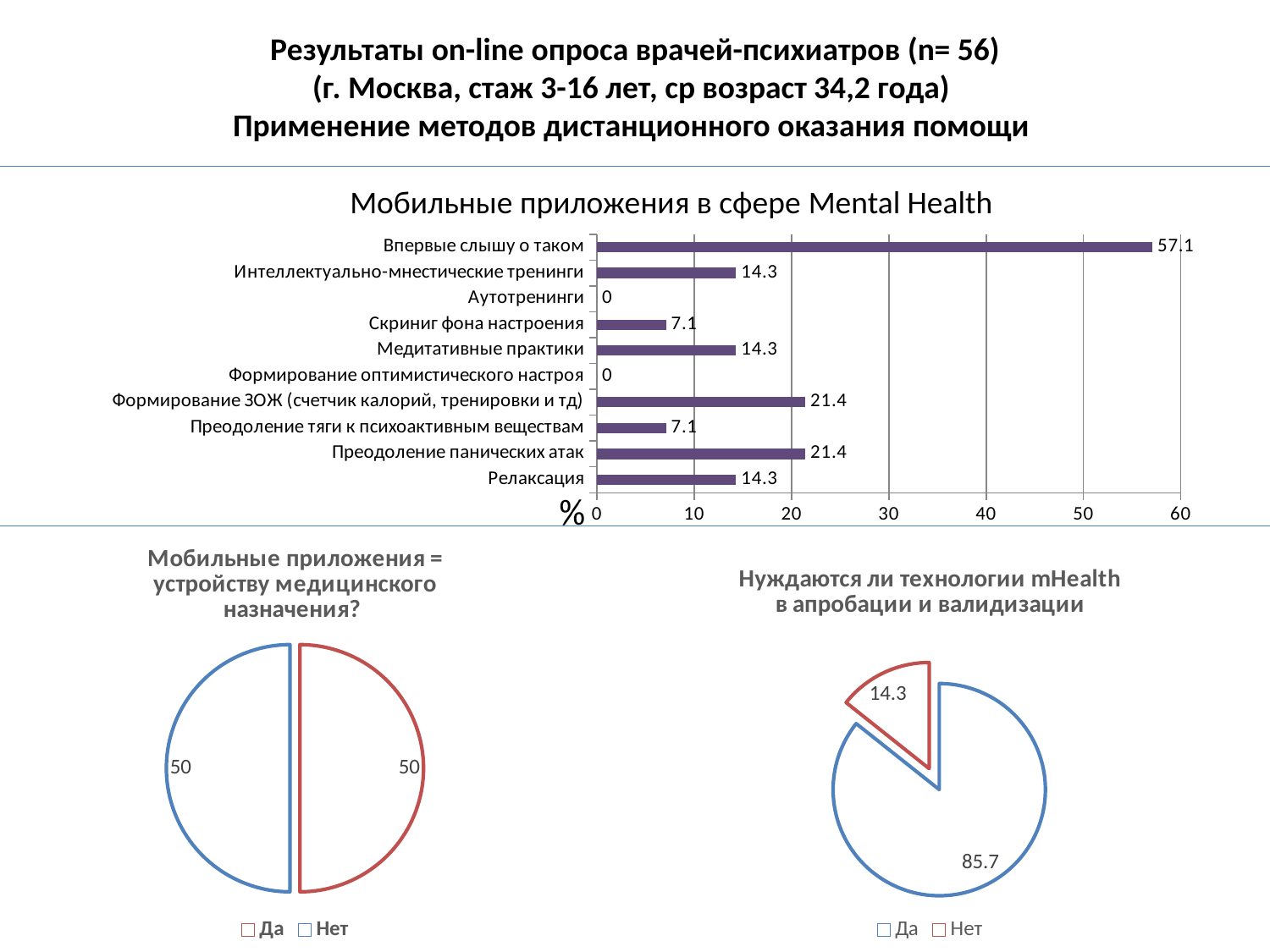
In the bar chart 'Мобильные приложения в сфере Mental Health', what is the value for 'Впервые слышу о таком'? 57.1 In the bar chart 'Мобильные приложения в сфере Mental Health', what is the difference between 'Впервые слышу о таком' and 'Формирование ЗОЖ (счетчик калорий, тренировки и тд)'? 35.7 In the bar chart 'Мобильные приложения в сфере Mental Health', which is larger: 'Релаксация' or 'Скриниг фона настроения'? Релаксация In the bar chart 'Мобильные приложения в сфере Mental Health', what is the value for 'Преодоление панических атак'? 21.4 In the pie chart 'Мобильные приложения = устройству медицинского назначения?', what is the value for 'Да'? 50 In the bar chart 'Мобильные приложения в сфере Mental Health', how many categories are shown? 10 In the bar chart 'Мобильные приложения в сфере Mental Health', which category has the highest value? Впервые слышу о таком What type of chart is 'Мобильные приложения в сфере Mental Health'? Bar chart In the bar chart 'Мобильные приложения в сфере Mental Health', how many categories have a value of 0? 2 How many entries does the legend of the pie chart 'Нуждаются ли технологии mHealth в апробации и валидизации' list? 2 In the pie chart 'Нуждаются ли технологии mHealth в апробации и валидизации', what is the value for 'Нет'? 14.3 In the pie chart 'Нуждаются ли технологии mHealth в апробации и валидизации', which slice is larger: 'Да' or 'Нет'? Да